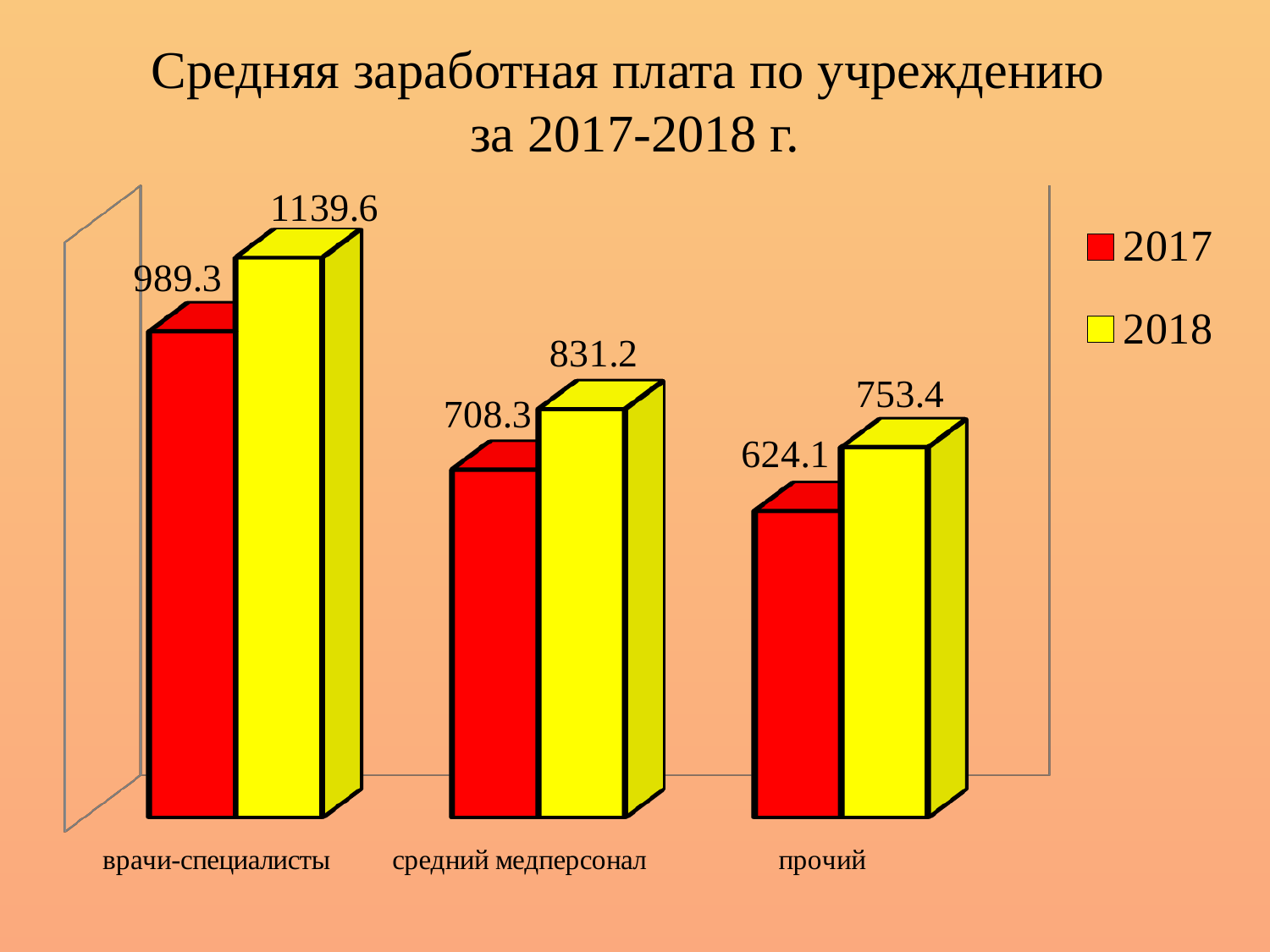
What kind of chart is shown on the slide? bar chart What is the value for прочий in 2018? 753.4 Which is larger: the 2017 value for средний медперсонал or the 2018 value for прочий? 2018 value for прочий What is the value for средний медперсонал in 2017? 708.3 What is the difference between the 2018 and 2017 values for врачи-специалисты? 150.3 How many categories are shown on the x axis? 3 What is the value for врачи-специалисты in 2018? 1139.6 How many series does the legend list? 2 Which colour represents the 2018 series? yellow Which category has the highest value in 2017? врачи-специалисты What is the difference between the 2018 and 2017 values for прочий? 129.3 Which category has the lowest value in 2018? прочий